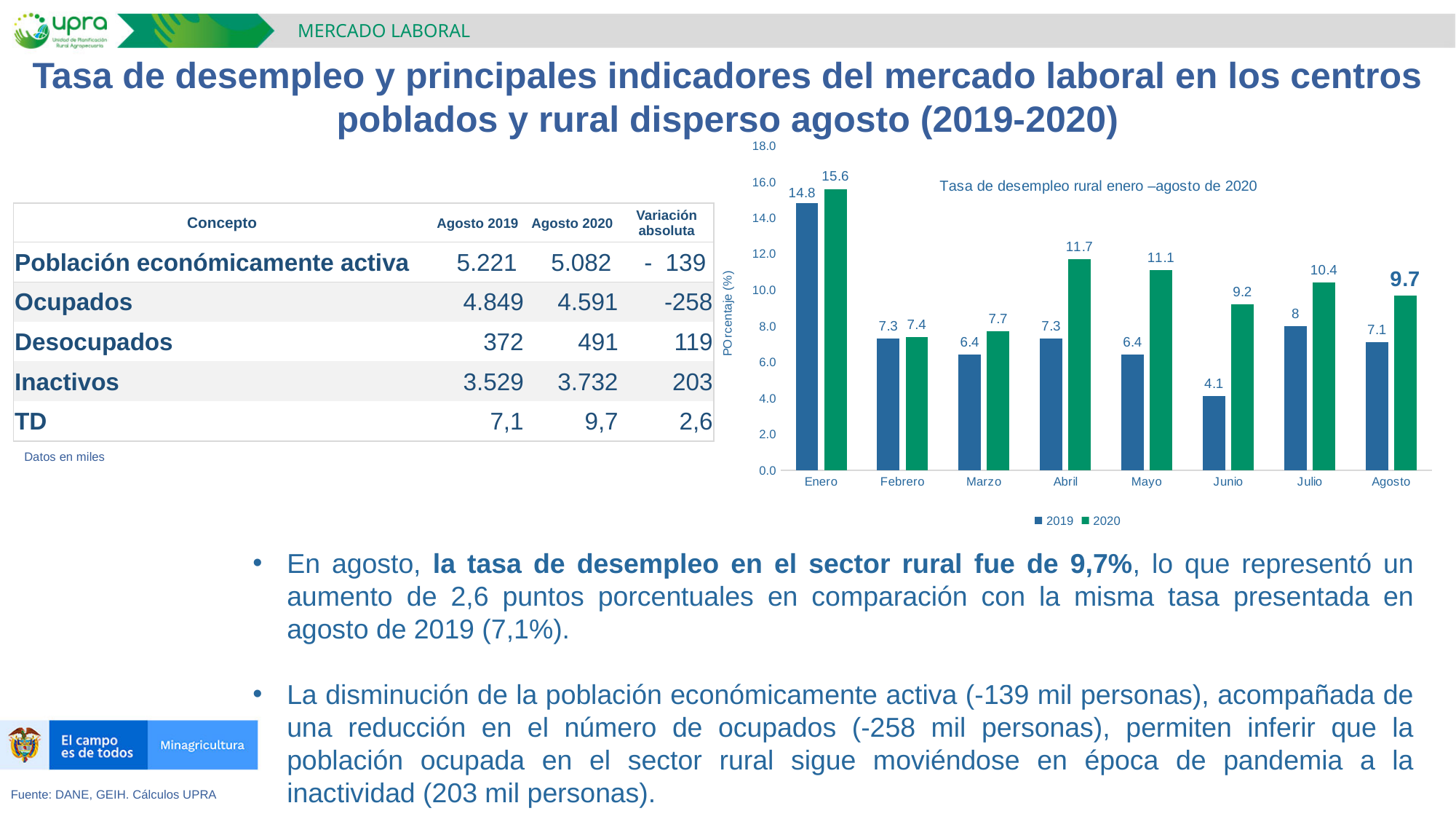
How many series does the chart legend list? 2 Is the 2020 value for Junio greater or less than 8.0 in the chart? greater What is the 2019 value for Junio in the chart? 4.1 Which is larger in the chart: the 2019 value for Julio or the 2019 value for Agosto? 2019 value for Julio What is the difference between the 2020 and 2019 values for Mayo in the chart? 4.7 Which month has the highest 2020 value in the chart? Enero What is the 2020 value for Abril in the chart? 11.7 How many months are shown on the x axis of the chart? 8 What is the title of the chart? Tasa de desempleo rural enero –agosto de 2020 What type of chart is shown on the slide? bar chart Which month has the lowest 2019 value in the chart? Junio What is the 2020 value for Agosto in the chart? 9.7